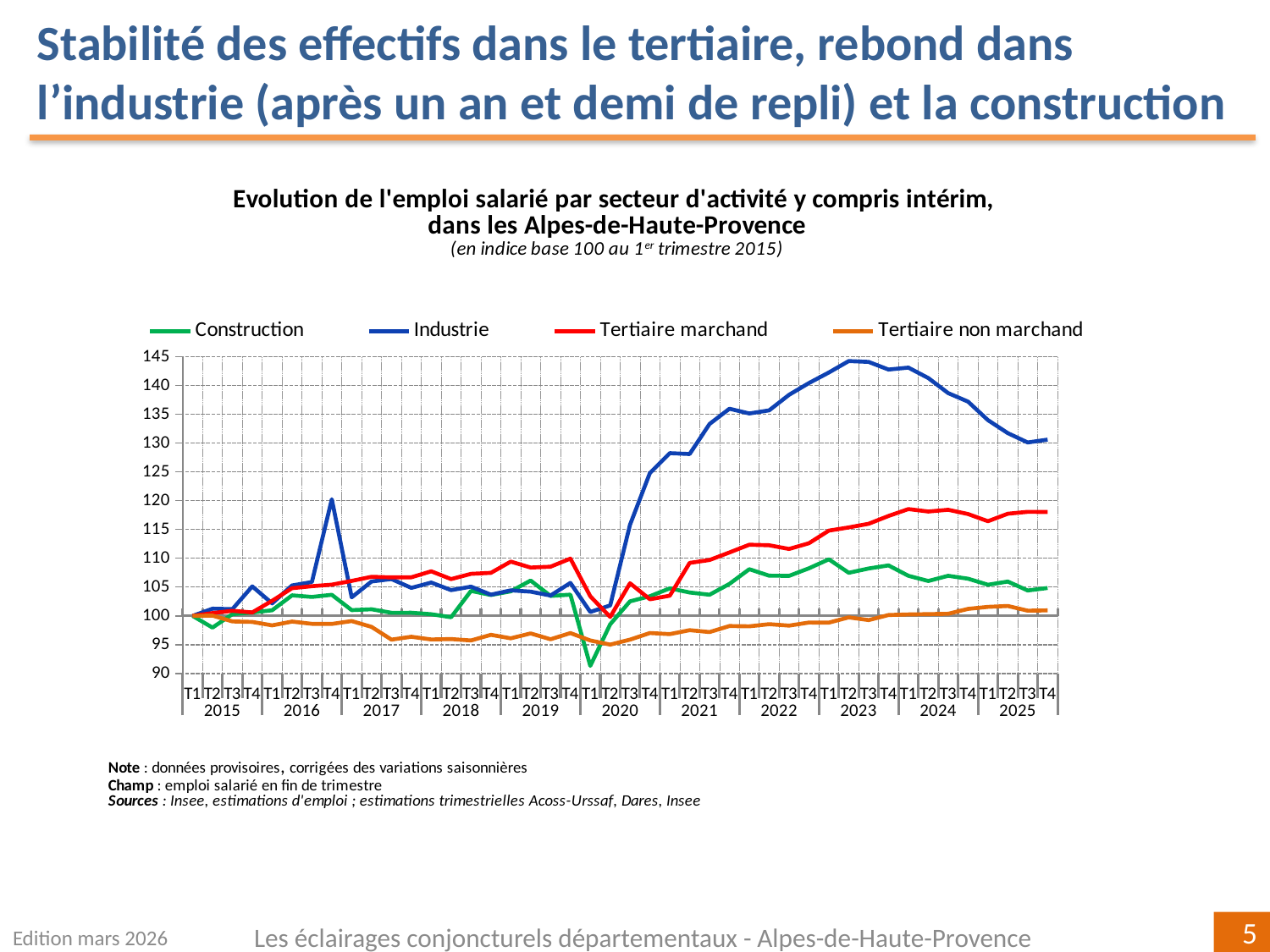
How many series does the legend list? 4 Which series has the lowest value at T4 2025? Tertiaire non marchand How many years are labelled along the x axis? 11 Is the value for Industrie at T4 2025 greater or less than 125? greater At T4 2025, which is larger: Industrie or Construction? Industrie What kind of chart is shown on the slide? line chart Is the value for Tertiaire non marchand at T3 2017 greater or less than 100? less Is the value for Construction at T1 2020 greater or less than 95? less Which series is plotted in blue? Industrie Which series has the highest value at T4 2025? Industrie Does the Industrie series rise or fall between 2023 and 2025? fall